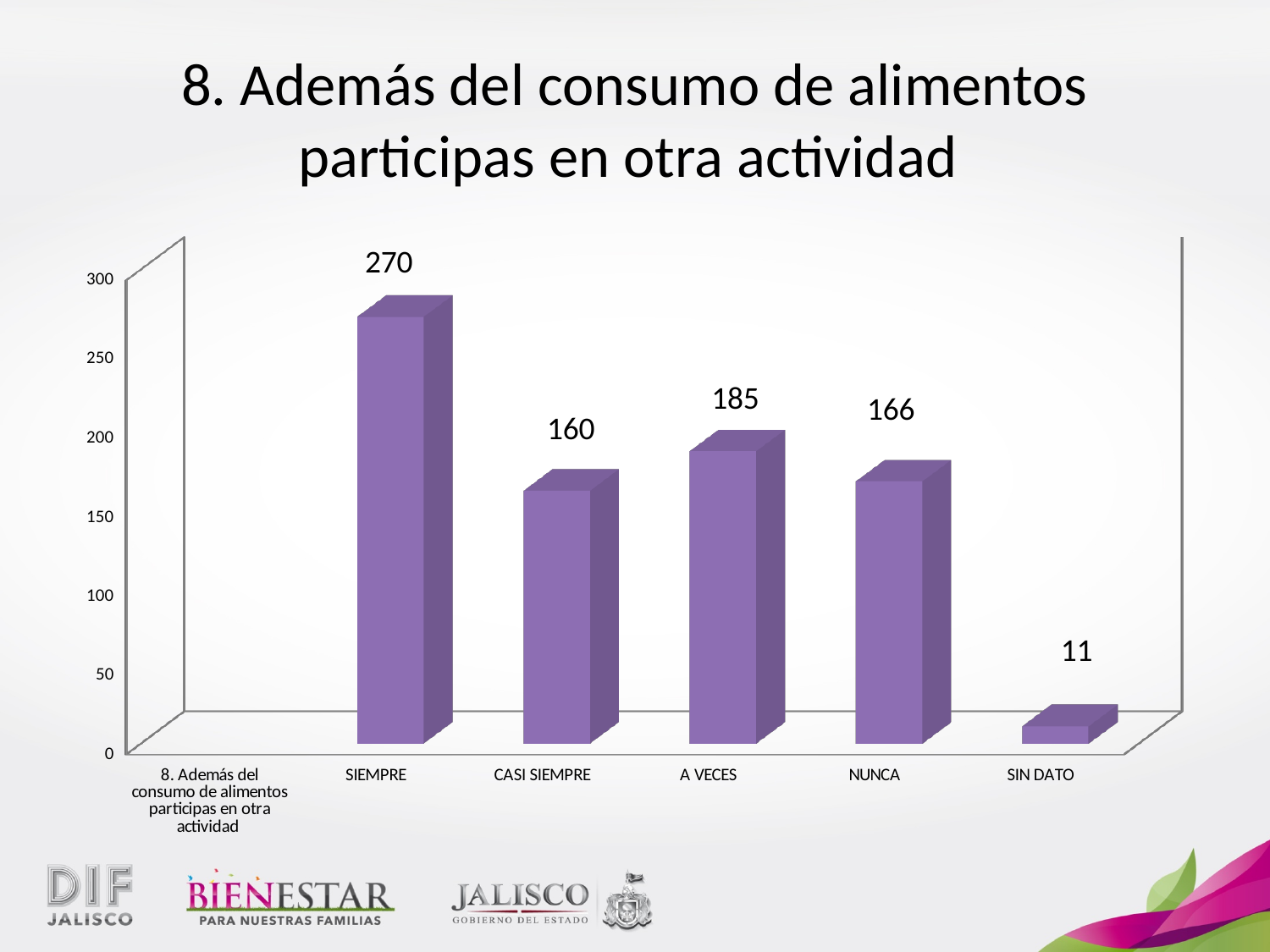
Is the value for NUNCA greater or less than 200? less Which is larger, the value for A VECES or the value for NUNCA? A VECES What is the value for CASI SIEMPRE? 160 How many bars are plotted in the chart? 5 What is the difference between the values for SIEMPRE and CASI SIEMPRE? 110 What kind of chart is shown on the slide? bar chart What is the value for SIN DATO? 11 What is the value for SIEMPRE? 270 Which category has the lowest value? SIN DATO What is the value for NUNCA? 166 Which category has the highest value? SIEMPRE What is the value for A VECES? 185